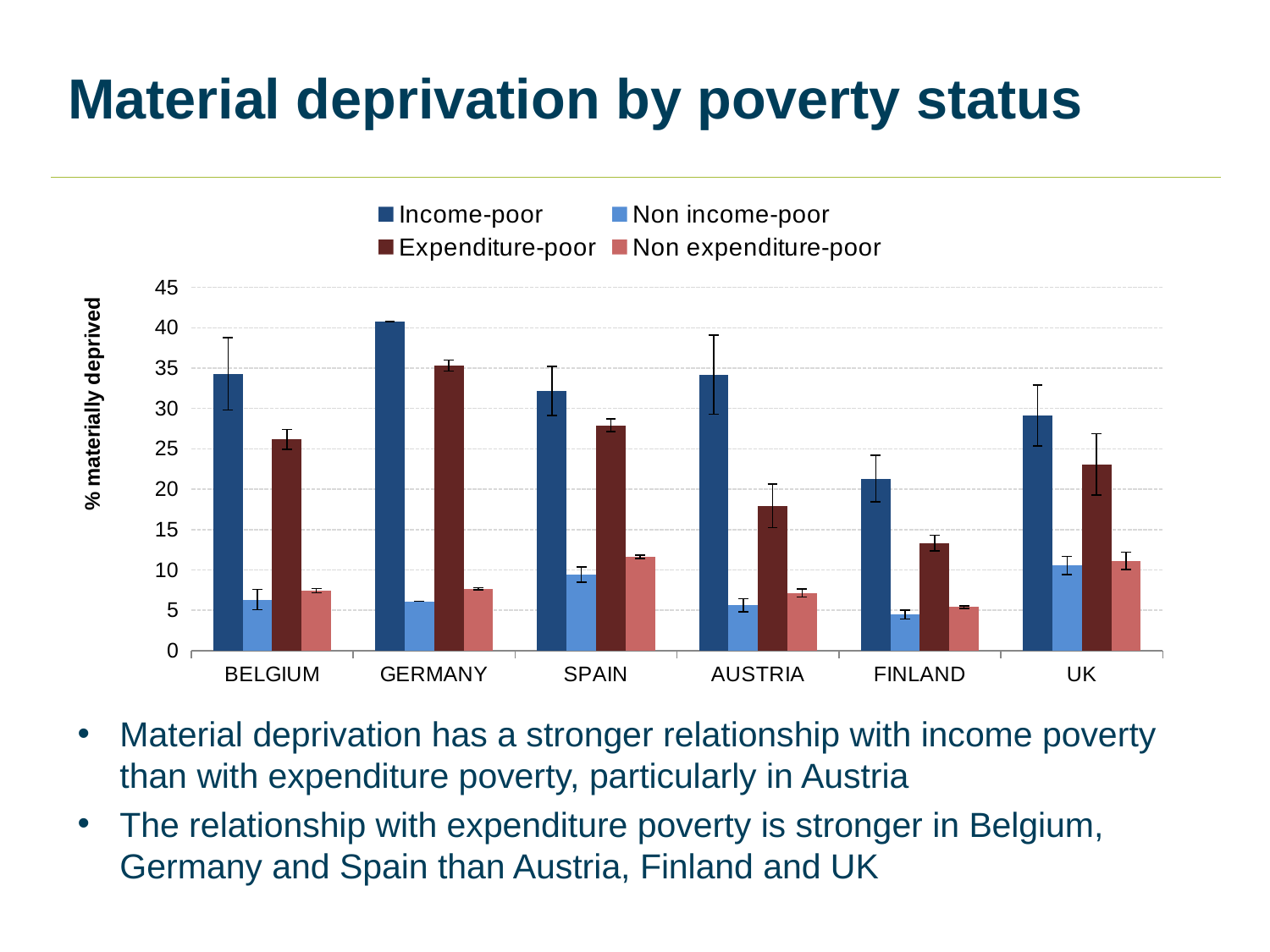
Which is larger, the Expenditure-poor value for Spain or the Expenditure-poor value for Austria? Spain What kind of chart is shown on the slide? bar chart How many countries are shown on the x axis of the chart? 6 Is the Expenditure-poor value for Austria greater or less than 20? less Which country has the highest Expenditure-poor value? GERMANY Is the Income-poor value for Finland greater or less than 25? less Which country has the lowest Expenditure-poor value? FINLAND Is the Income-poor value for Germany greater or less than 35? greater How many series does the chart's legend list? 4 Which country has the lowest Income-poor value? FINLAND What is the label on the vertical axis of the chart? % materially deprived Which country has the highest Income-poor value? GERMANY